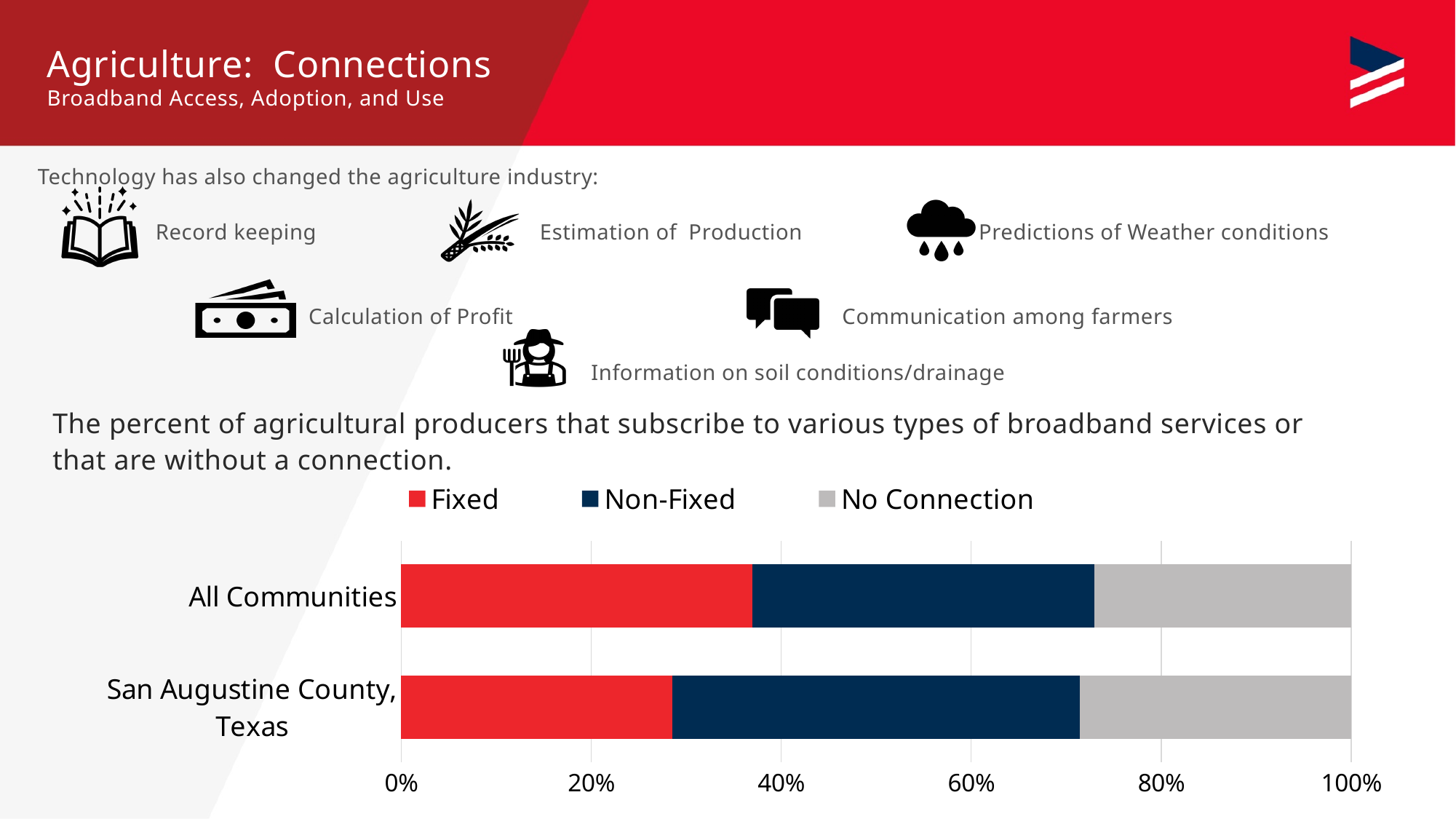
What kind of chart is shown on the slide? Stacked bar chart What is the highest value shown on the chart's horizontal axis? 100% Which category has the larger Non-Fixed share: All Communities or San Augustine County, Texas? San Augustine County, Texas How many categories are plotted on the chart? 2 Which category has the larger Fixed share: All Communities or San Augustine County, Texas? All Communities Is the Fixed value for San Augustine County, Texas greater or less than 40%? less How many series does the chart's legend list? 3 What is the total of each stacked bar on the chart? 100% What are the three series listed in the chart's legend? Fixed, Non-Fixed, No Connection Which colour represents the Fixed series in the chart? Red Is the Fixed value for San Augustine County, Texas greater or less than 20%? greater Is the Fixed value for All Communities greater or less than 20%? greater